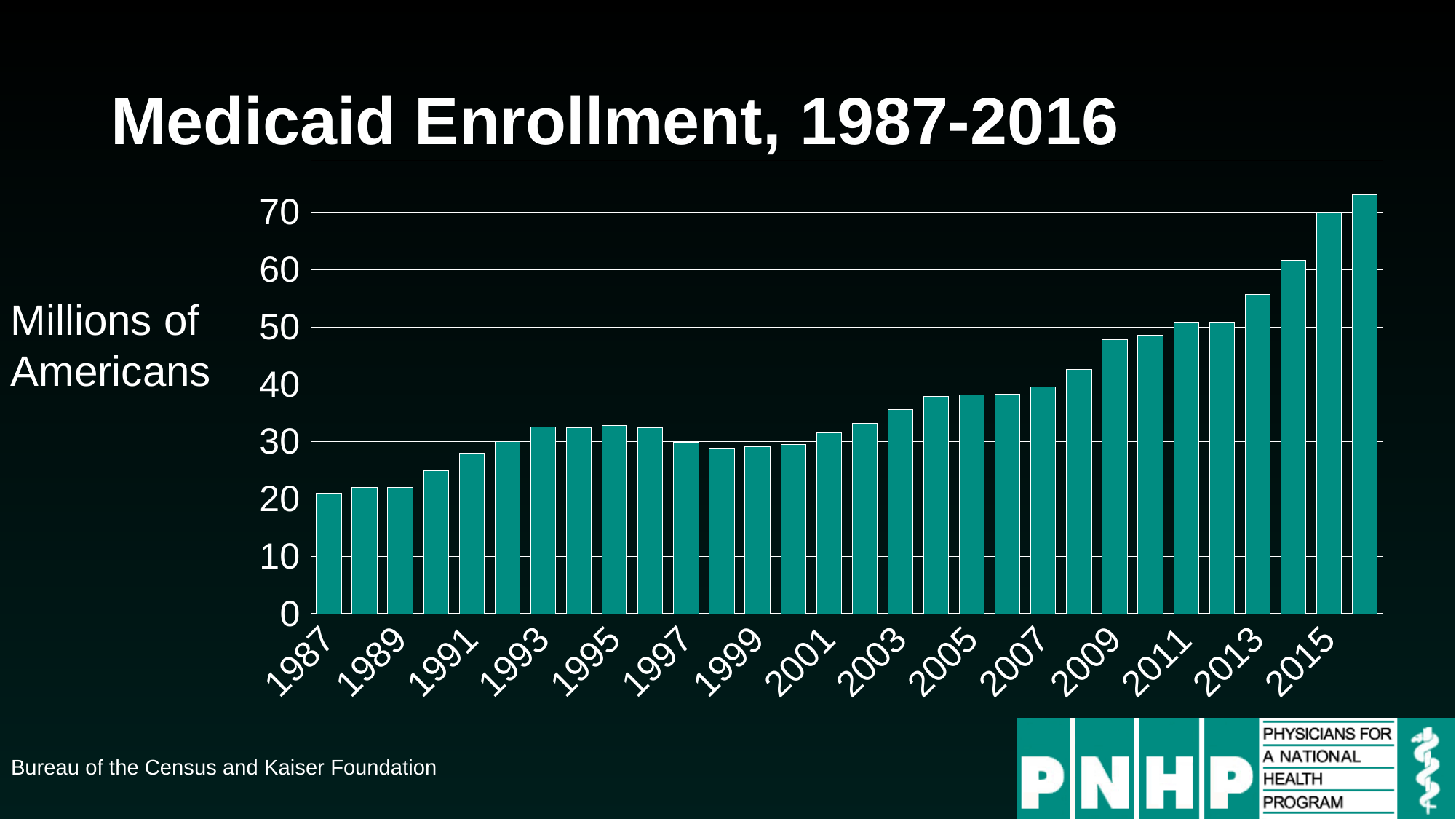
Is the value for 2009 greater or less than 40? greater What unit does the y-axis label say the values are in? Millions of Americans How many bars (years) are plotted in the chart? 30 Which labeled year has the lowest Medicaid enrollment? 1987 What is the title of the chart? Medicaid Enrollment, 1987-2016 What kind of chart is shown on the slide? Bar chart Which is larger, the value for 2009 or the value for 1999? 2009 Is the value for 2015 greater or less than 60? greater Do the values generally rise or fall from 1987 to the end of the chart? Rise Is the value for 2013 greater or less than 50? greater